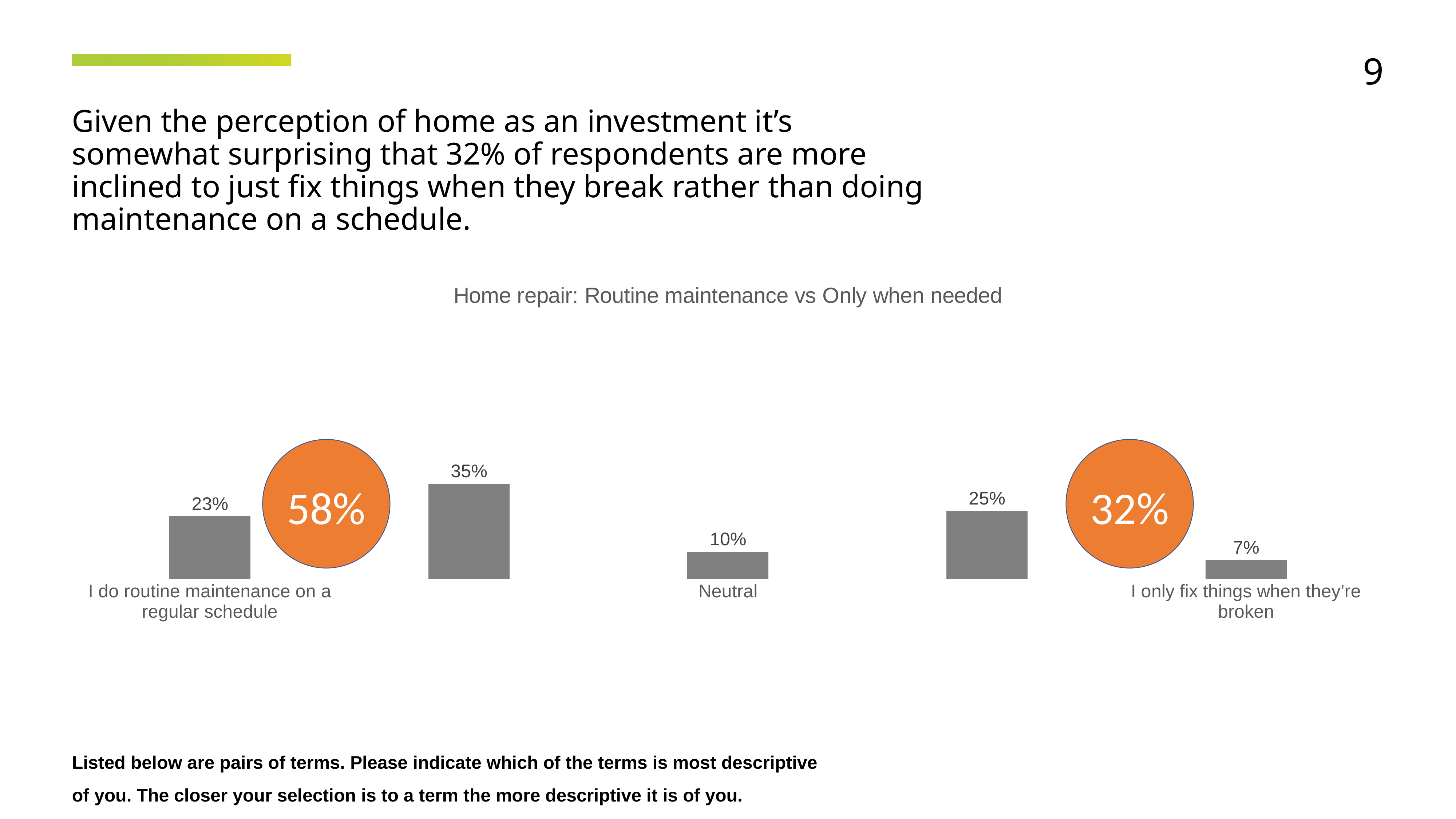
How many bars are plotted in the chart? 5 What is the value for the bar labelled "I do routine maintenance on a regular schedule"? 23% What is the title of the chart? Home repair: Routine maintenance vs Only when needed What is the value for Neutral? 10% What is the difference between the Neutral value and the value for "I only fix things when they're broken"? 3% What is the highest value shown on any bar in the chart? 35% Which labelled category has the lowest value? I only fix things when they're broken What is the difference between the value for "I do routine maintenance on a regular schedule" and the Neutral value? 13% Which is larger: the value for "I do routine maintenance on a regular schedule" or the value for Neutral? I do routine maintenance on a regular schedule What is the value for the bar labelled "I only fix things when they're broken"? 7% What kind of chart is shown on the slide? Bar chart What percentage is shown in the orange circle on the right side of the chart? 32%